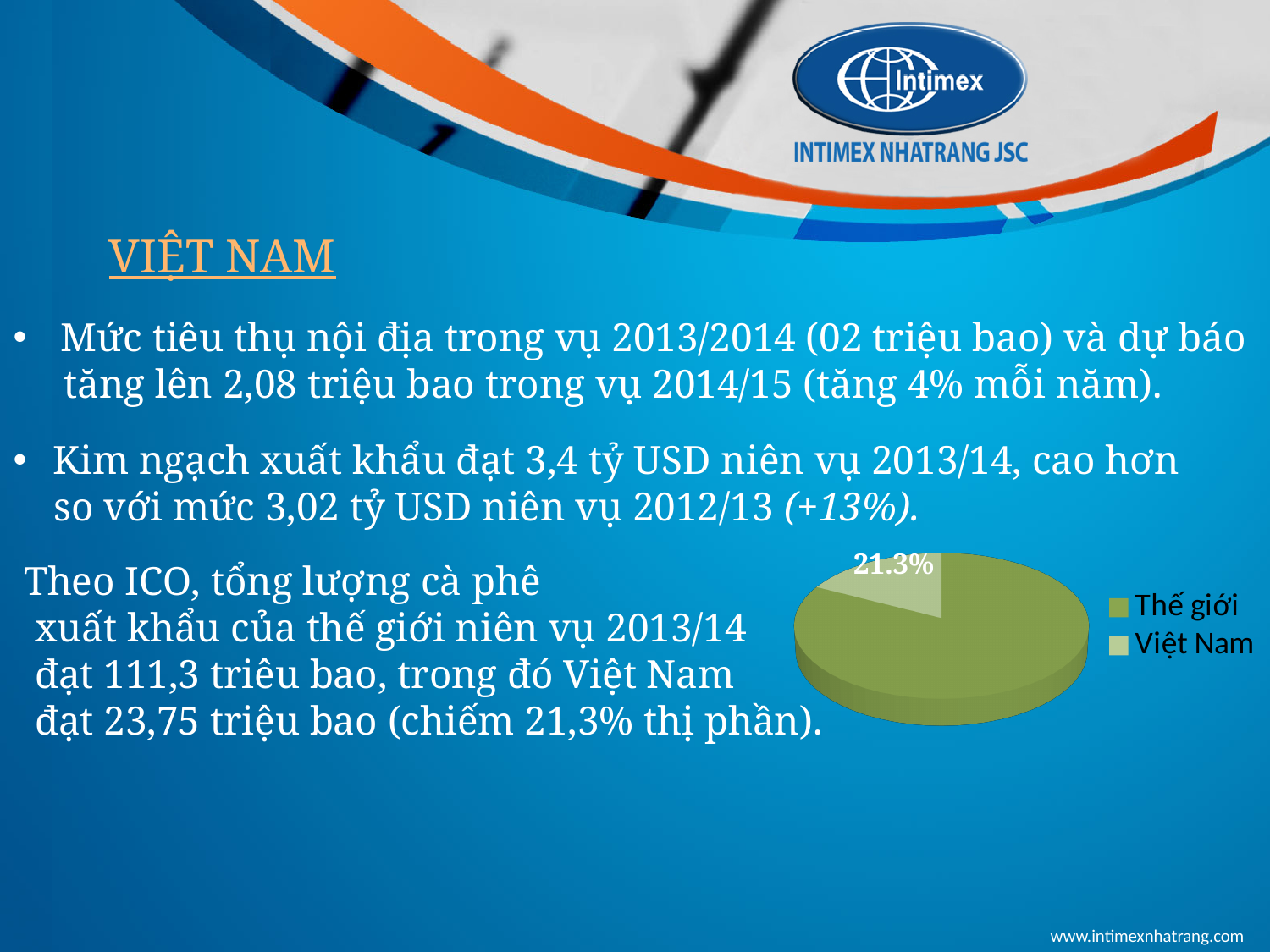
What share of the pie chart does Việt Nam represent? 21.3% What kind of chart is shown on the slide? pie chart Which legend entry of the pie chart is shown in the lighter green colour? Việt Nam What are the two legend entries of the pie chart? Thế giới and Việt Nam Which slice of the pie chart is the largest? Thế giới In the pie chart, which is larger: Thế giới or Việt Nam? Thế giới How many slices does the pie chart have? 2 What percentage is printed on the Việt Nam slice of the pie chart? 21.3% Which slice of the pie chart is the smallest? Việt Nam How many entries does the legend of the pie chart list? 2